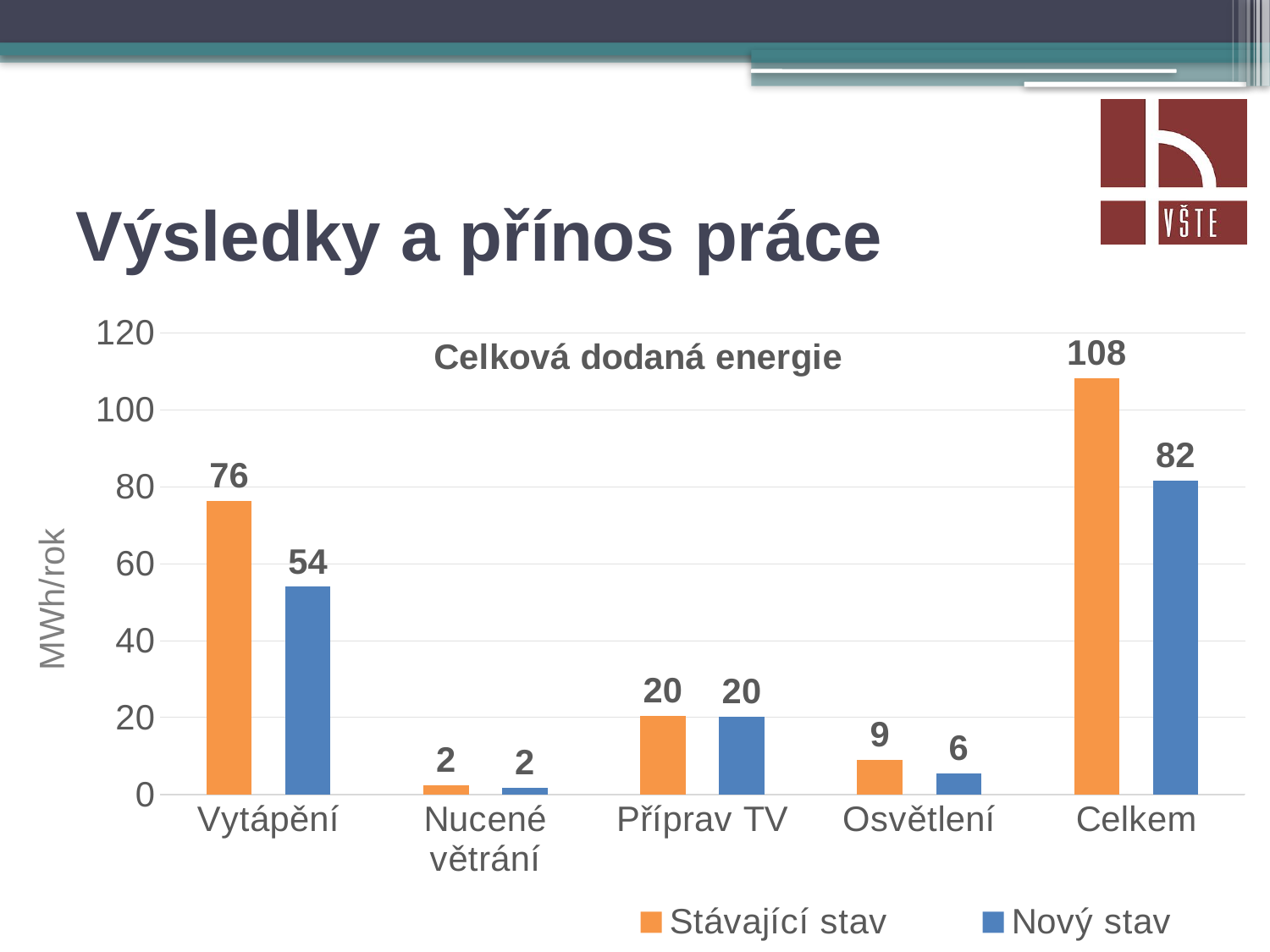
How many categories are shown on the x axis? 5 What is the value for Stávající stav in the Vytápění category? 76 How many series does the legend list? 2 What is the value for Nový stav in the Osvětlení category? 6 What is the difference between Stávající stav and Nový stav in the Celkem category? 26 What is the title of the chart? Celková dodaná energie What kind of chart is shown on the slide? Bar chart Which category has the lowest value for Nový stav? Nucené větrání What is the difference between Stávající stav and Nový stav in the Vytápění category? 22 Which category has the highest value for Stávající stav? Celkem What is the value for Nový stav in the Celkem category? 82 Which is larger in the Osvětlení category, Stávající stav or Nový stav? Stávající stav